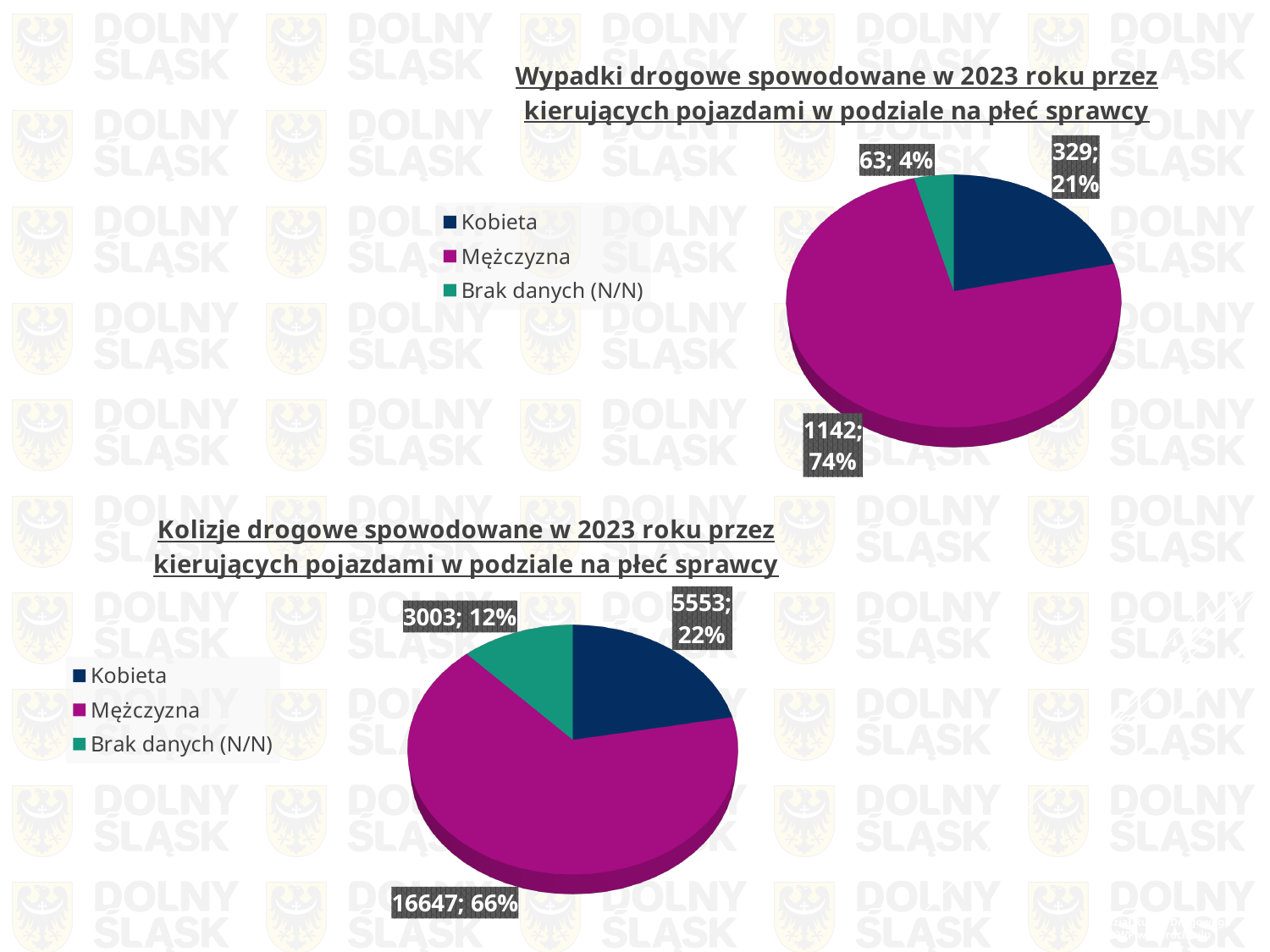
In the bottom chart (Kolizje drogowe), what is the difference between the values for Mężczyzna and Kobieta? 11094 In the top chart (Wypadki drogowe), what percentage share does Kobieta have? 21% In the bottom chart (Kolizje drogowe), what percentage share does Brak danych (N/N) have? 12% In the bottom chart (Kolizje drogowe), which is larger, the value for Kobieta or for Brak danych (N/N)? Kobieta How many categories does the legend of the top chart (Wypadki drogowe) list? 3 In the bottom chart (Kolizje drogowe), what value is shown for Kobieta? 5553 In the top chart (Wypadki drogowe), what is the difference between the values for Mężczyzna and Kobieta? 813 What type of chart is the bottom chart (Kolizje drogowe)? Pie chart In the top chart (Wypadki drogowe), what value is shown for Brak danych (N/N)? 63 In the top chart (Wypadki drogowe), what value is shown for Mężczyzna? 1142 In the bottom chart (Kolizje drogowe), which category has the largest slice? Mężczyzna In the top chart (Wypadki drogowe), which category has the smallest slice? Brak danych (N/N)